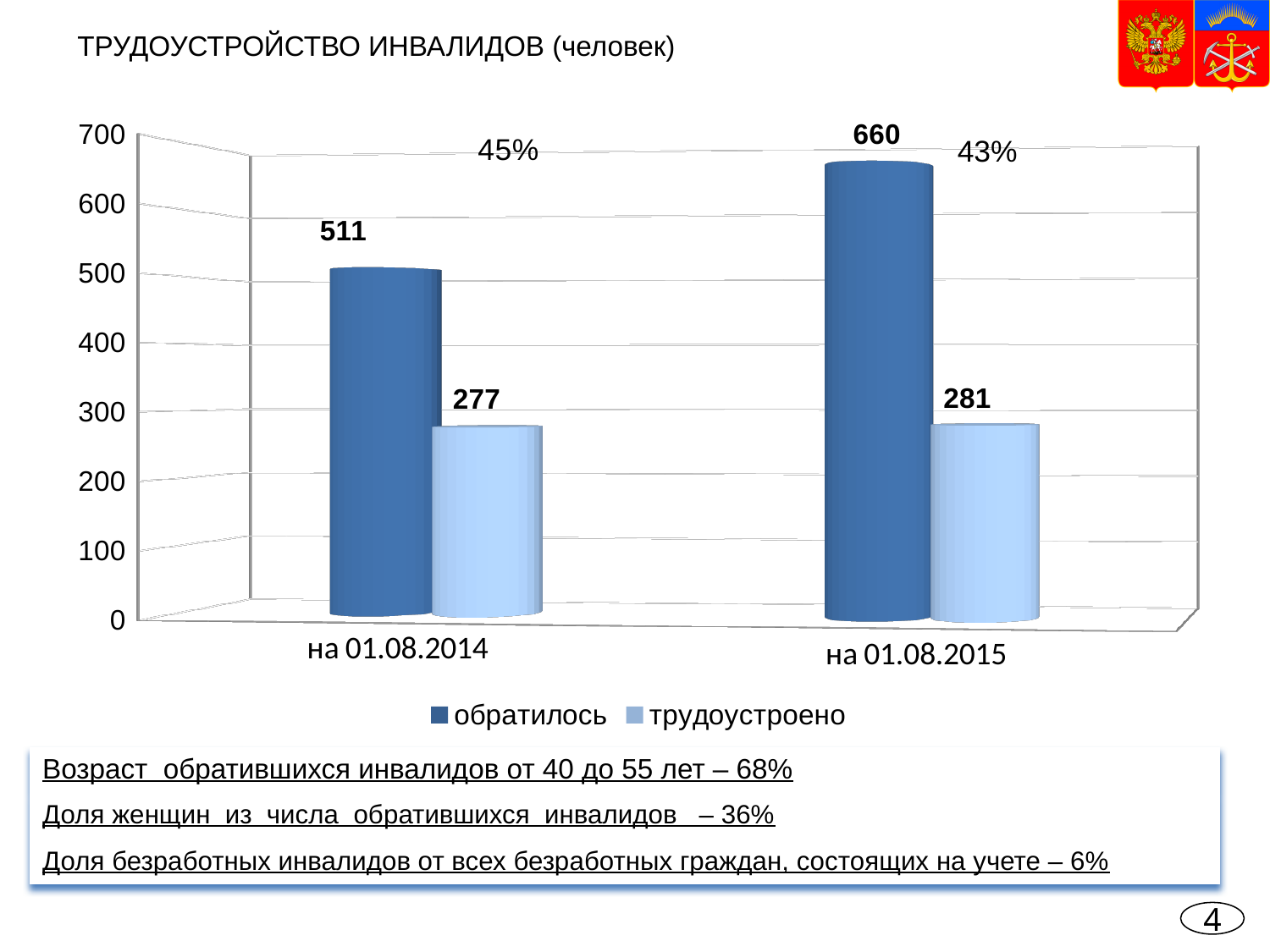
Is the value of "обратилось" for "на 01.08.2015" greater or less than 600? greater Which is larger: "обратилось" for "на 01.08.2014" or "трудоустроено" for "на 01.08.2015"? обратилось for на 01.08.2014 What is the value of "трудоустроено" for "на 01.08.2015"? 281 What percentage label is shown above the bars for "на 01.08.2015"? 43% Which category has the highest value for "обратилось"? на 01.08.2015 What is the difference between "обратилось" and "трудоустроено" for "на 01.08.2014"? 234 What is the value of "обратилось" for "на 01.08.2014"? 511 What kind of chart is shown on the slide? bar chart What is the value of "обратилось" for "на 01.08.2015"? 660 How many series does the legend list? 2 What is the value of "трудоустроено" for "на 01.08.2014"? 277 What is the difference between "обратилось" for "на 01.08.2015" and "на 01.08.2014"? 149